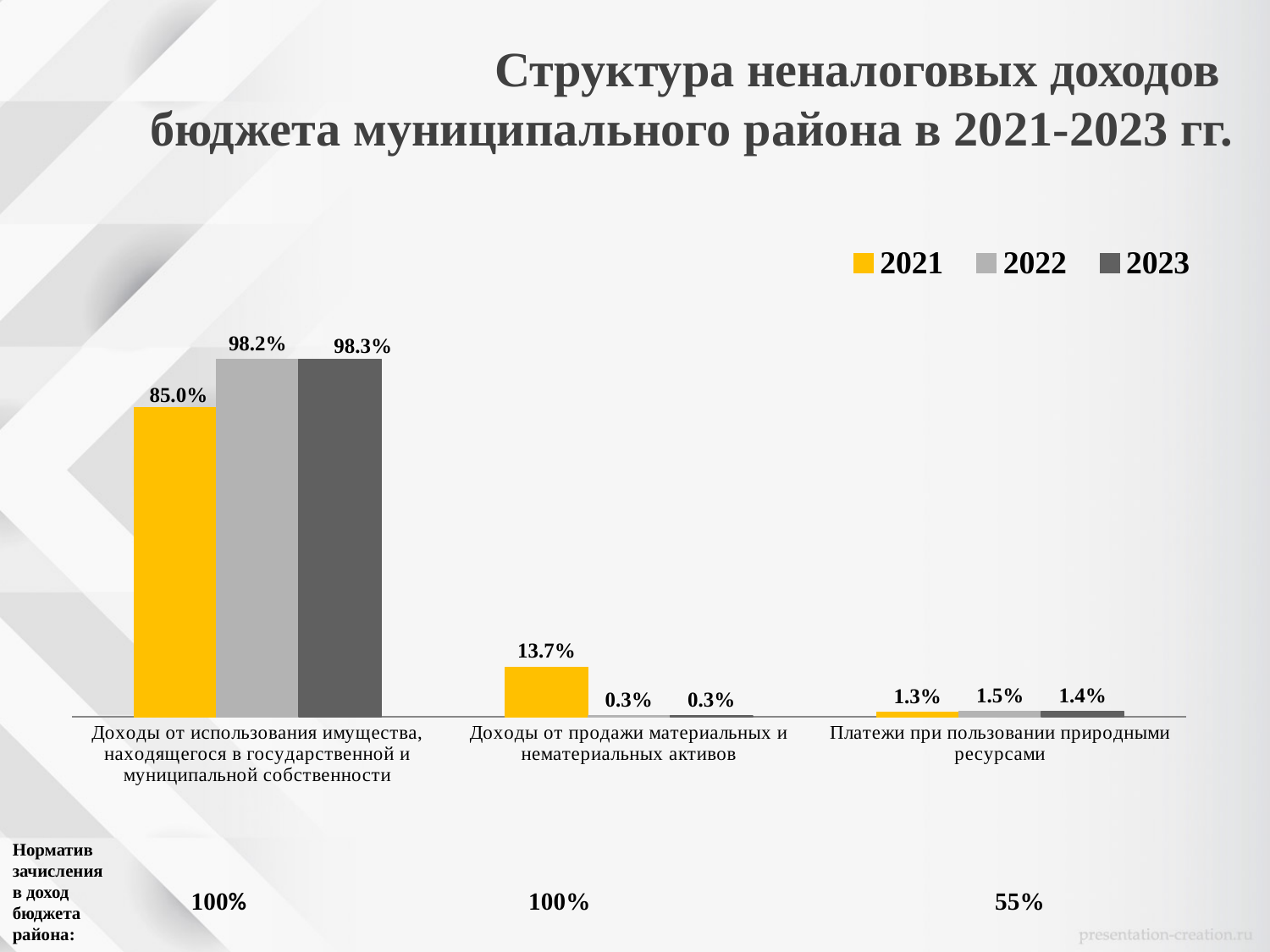
What is the value for 2023 in the category 'Доходы от продажи материальных и нематериальных активов'? 0.3% Which year has the highest value in the category 'Доходы от использования имущества, находящегося в государственной и муниципальной собственности'? 2023 What is the value for 2021 in the category 'Доходы от использования имущества, находящегося в государственной и муниципальной собственности'? 85.0% Which year has the lowest value in the category 'Платежи при пользовании природными ресурсами'? 2021 Which is larger: the 2021 value for 'Доходы от продажи материальных и нематериальных активов' or the 2021 value for 'Платежи при пользовании природными ресурсами'? Доходы от продажи материальных и нематериальных активов What is the value for 2022 in the category 'Платежи при пользовании природными ресурсами'? 1.5% How many categories are shown on the x axis of the chart? 3 What is the value for 2021 in the category 'Доходы от продажи материальных и нематериальных активов'? 13.7% How many series does the legend list? 3 What kind of chart is shown on the slide? Bar chart What is the difference between the 2022 and 2021 values in the category 'Доходы от использования имущества, находящегося в государственной и муниципальной собственности'? 13.2% What is the difference between the 2021 and 2022 values in the category 'Доходы от продажи материальных и нематериальных активов'? 13.4%